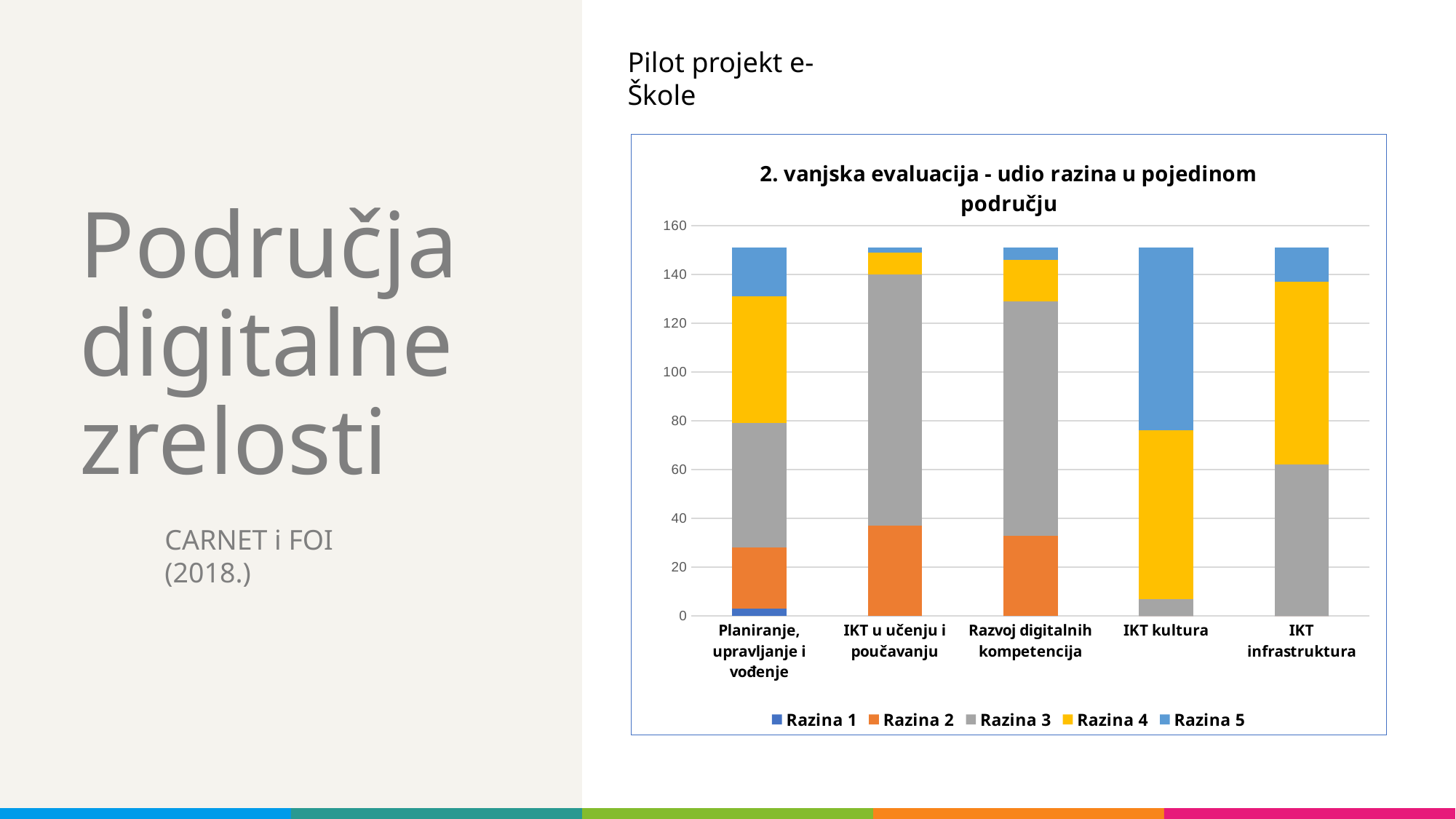
Which category has the largest Razina 5 segment? IKT kultura How many series does the chart legend list? 5 Is the Razina 5 segment for IKT kultura greater or less than 60? greater What is the title of the chart? 2. vanjska evaluacija - udio razina u pojedinom području Which is larger: the Razina 5 segment for IKT kultura or the Razina 5 segment for Planiranje, upravljanje i vođenje? IKT kultura Which series is shown in yellow in the chart? Razina 4 Is the Razina 3 segment for IKT infrastruktura greater or less than 40? greater Which is larger: the Razina 4 segment for IKT infrastruktura or the Razina 4 segment for Planiranje, upravljanje i vođenje? IKT infrastruktura What kind of chart is shown on the slide? Stacked bar chart Is the Razina 2 segment for IKT u učenju i poučavanju greater or less than 20? greater How many categories are shown on the x axis of the chart? 5